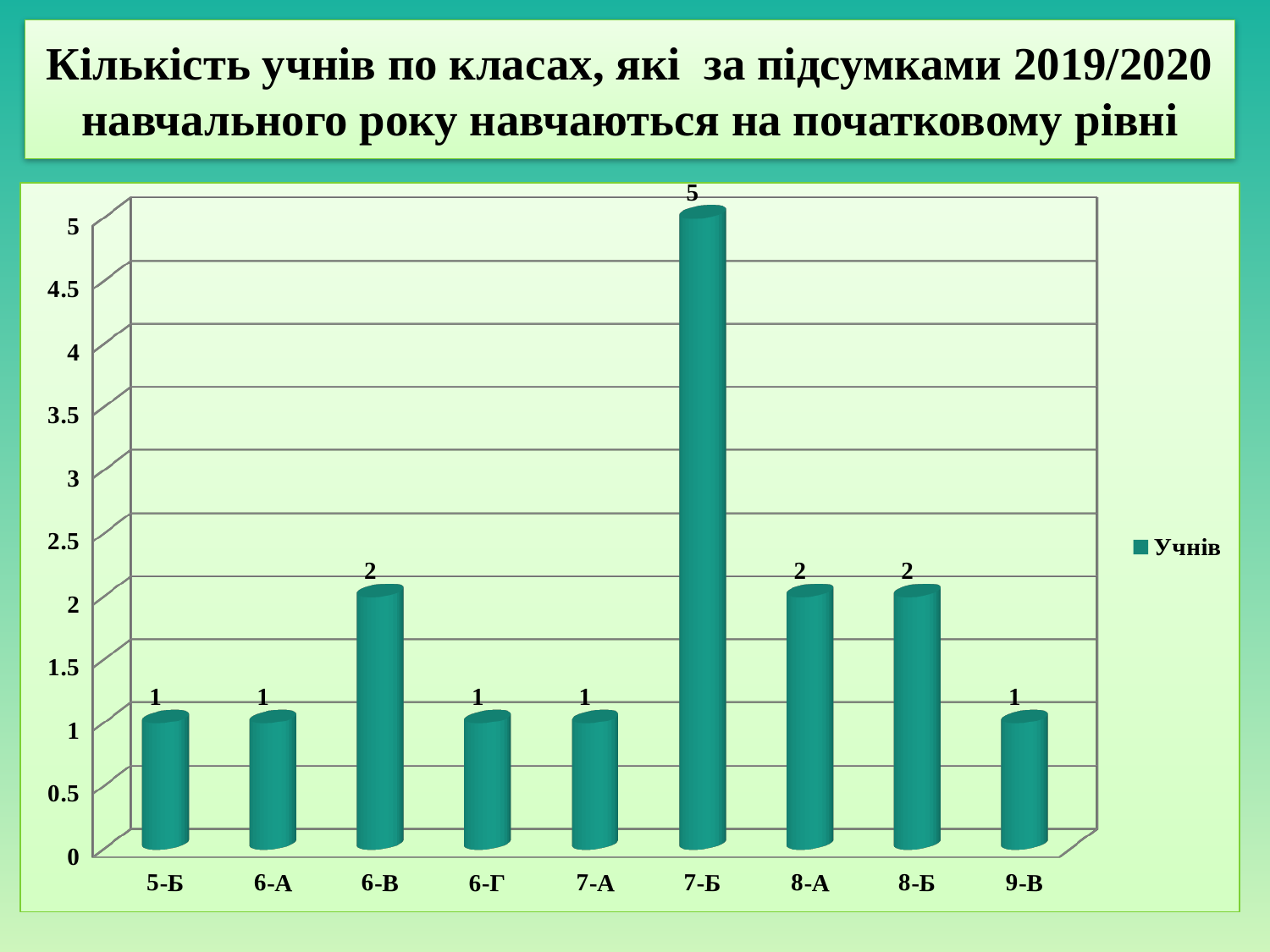
How many classes are shown on the x axis? 9 Is the value for 7-Б greater or less than 4? greater What is the difference between the values for 6-В and 6-Г? 1 Which class has the highest value? 7-Б What is the value for class 7-Б? 5 What is the value for class 6-В? 2 What kind of chart is shown? bar chart What is the legend entry for the series? Учнів What is the difference between the values for 7-Б and 8-А? 3 What is the value for class 9-В? 1 How many series does the legend list? 1 Which is larger, the value for 8-Б or the value for 7-А? 8-Б